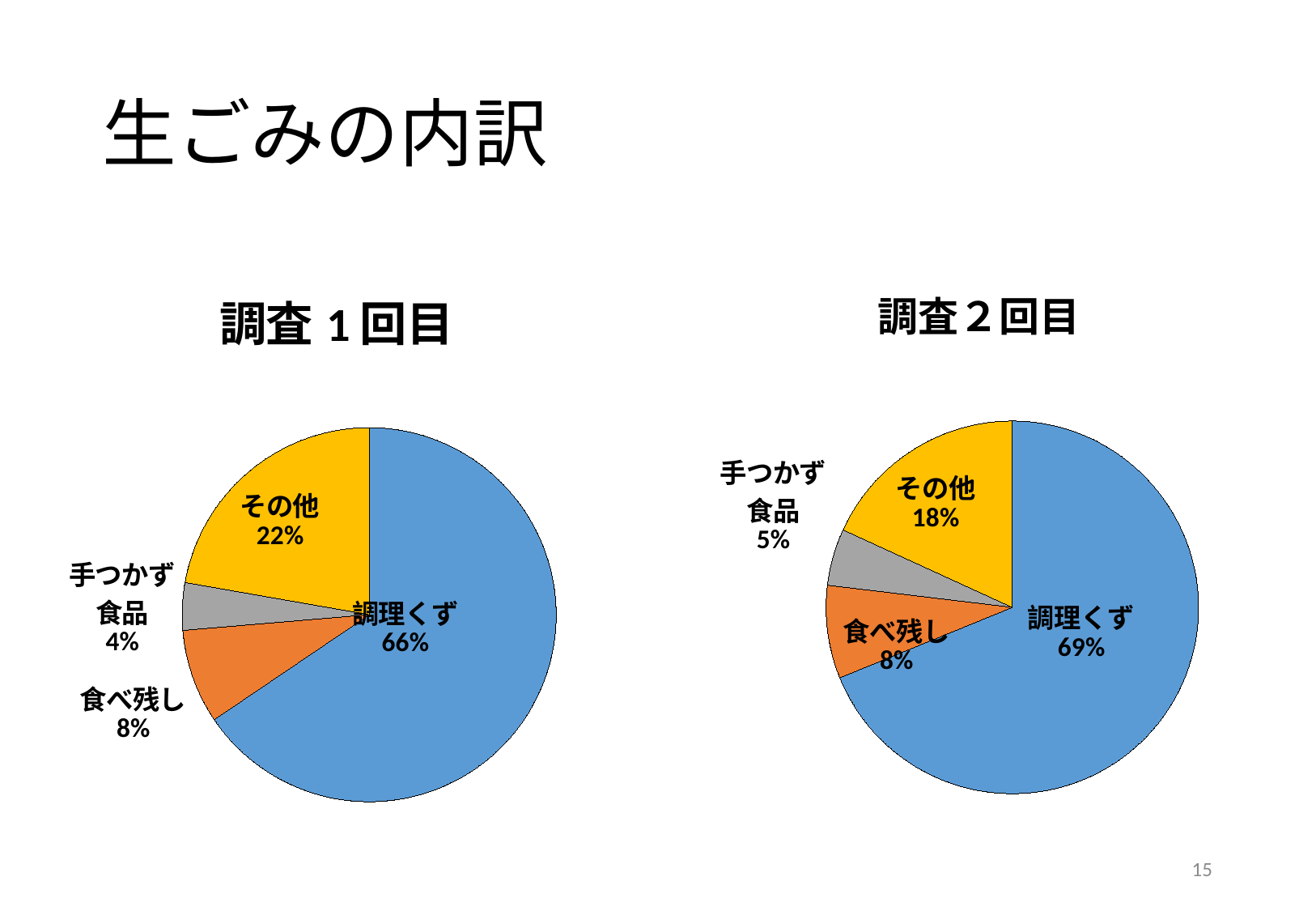
In the 調査１回目 pie chart, what is the difference between the shares of その他 and 食べ残し? 14% Which is larger: その他 in 調査１回目 or その他 in 調査２回目? その他 in 調査１回目 In the 調査１回目 pie chart, which category has the smallest share? 手つかず食品 How many categories does the 調査２回目 pie chart show? 4 What type of chart is used for 調査１回目? Pie chart In the 調査２回目 pie chart, which category has the largest share? 調理くず In the 調査２回目 pie chart, what share is 食べ残し? 8% In the 調査１回目 pie chart, what share is その他? 22% In the 調査２回目 pie chart, what share is 調理くず? 69% What colour is the 調理くず slice in the 調査１回目 pie chart? Blue